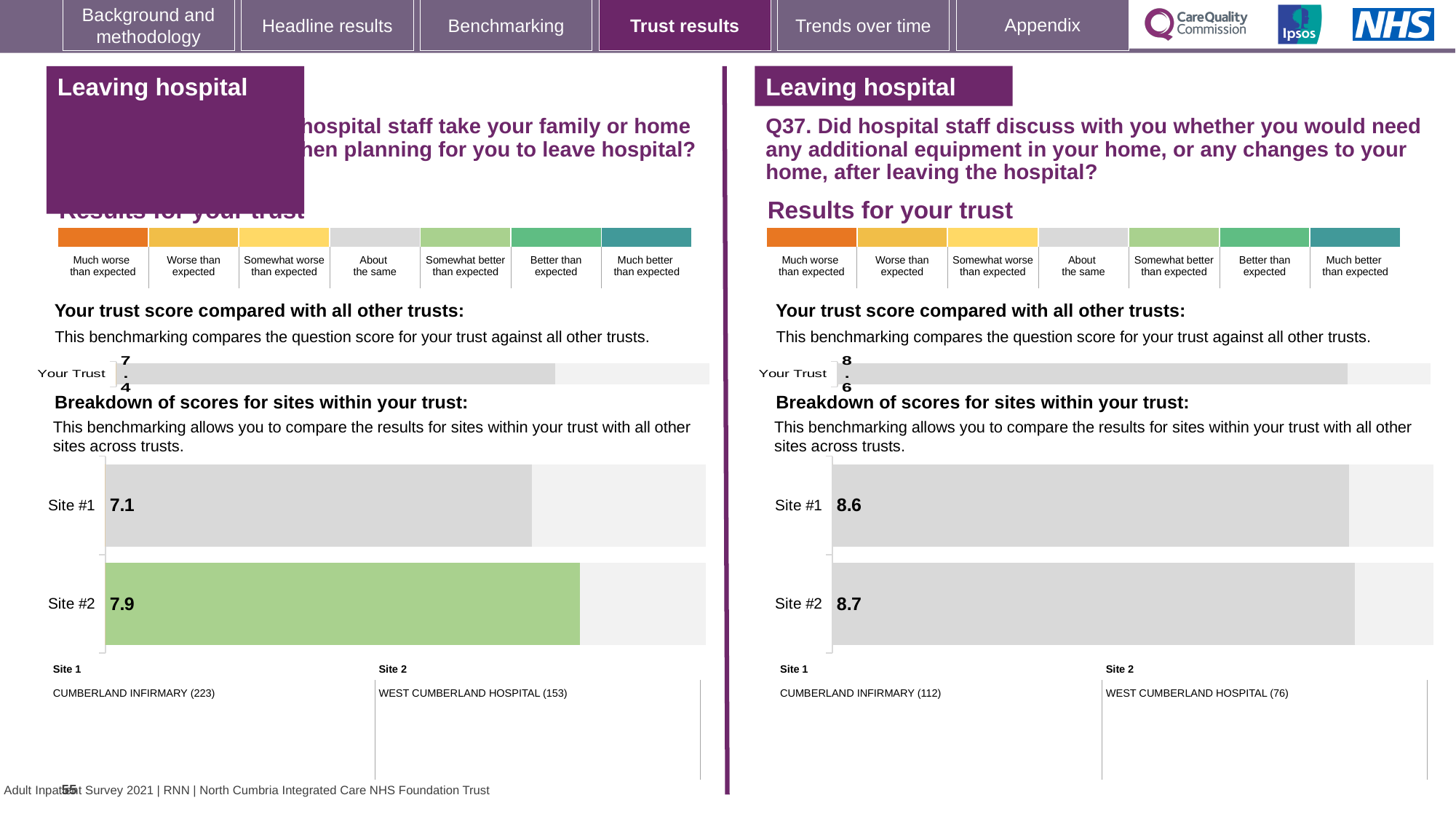
On the left-hand side of the slide, what is the score shown for Site #2 in the breakdown of scores for sites within your trust? 7.9 In the left-hand site breakdown chart, what is the difference between the Site #2 and Site #1 scores? 0.8 On the right-hand side of the slide (Q37), what is the score shown for Site #2 in the breakdown of scores for sites within your trust? 8.7 What type of chart is used for the site breakdown on the right-hand side of the slide (Q37)? Bar chart In the left-hand site breakdown chart, which site has the higher score? Site #2 In the left-hand site breakdown chart, which site's bar is coloured green? Site #2 On the right-hand side of the slide (Q37), what is the 'Your Trust' score in the trust score comparison chart? 8.6 On the right-hand side of the slide (Q37), what is the score shown for Site #1 in the breakdown of scores for sites within your trust? 8.6 In the right-hand (Q37) site breakdown chart, what is the difference between the Site #2 and Site #1 scores? 0.1 How many sites are shown in the left-hand site breakdown chart? 2 On the left-hand side of the slide, what is the score shown for Site #1 in the breakdown of scores for sites within your trust? 7.1 On the left-hand side of the slide, what is the 'Your Trust' score in the trust score comparison chart? 7.4